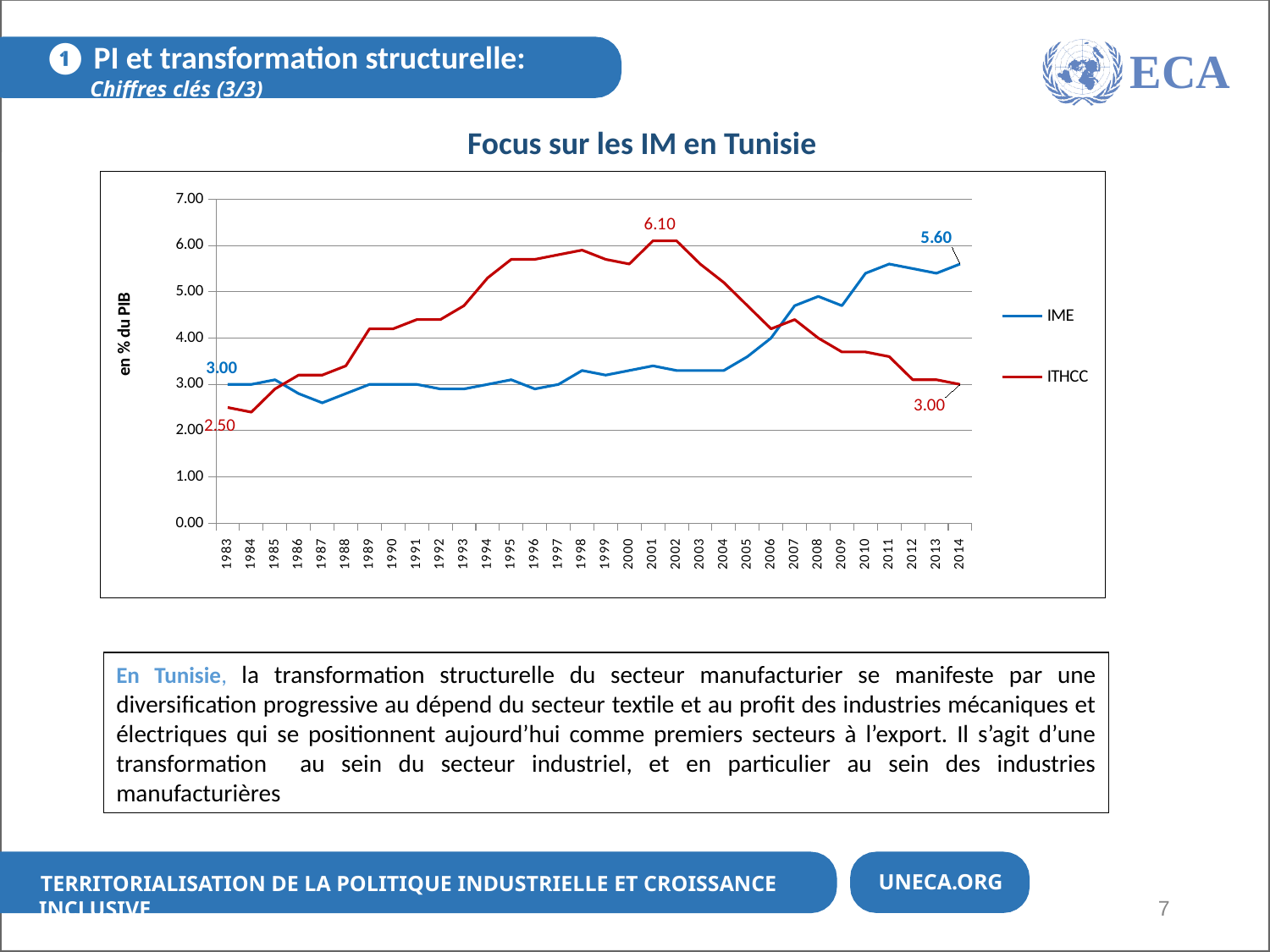
What is the value of ITHCC in 2002? 6.10 What is the value of IME in 2014? 5.60 What type of chart is shown on the slide? line chart What is the label of the vertical axis? en % du PIB What is the difference between the ITHCC value in 2002 and its value in 2014? 3.10 By how much did IME increase between 1983 and 2014? 2.60 How many series does the legend list? 2 In which year does the ITHCC series reach its highest value? 2001 and 2002 Does the ITHCC series rise or fall between 2002 and 2014? fall Is the value for ITHCC in 1995 greater or less than 5.00? greater In 2014, which series has the larger value, IME or ITHCC? IME What is the value of ITHCC in 1983? 2.50